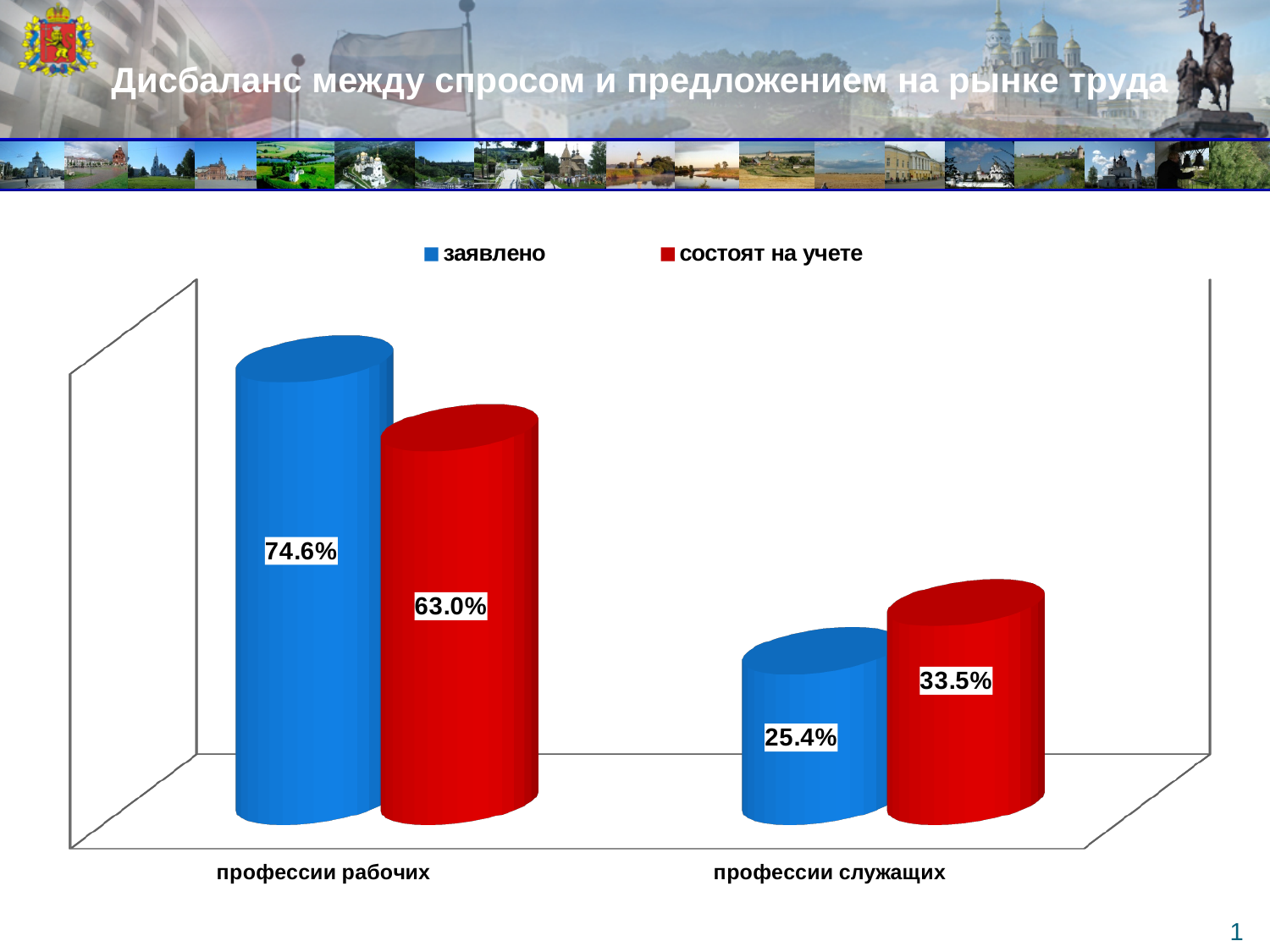
For "профессии служащих", which series has the larger value: "заявлено" or "состоят на учете"? состоят на учете What is the value for "состоят на учете" in the "профессии служащих" category? 33.5% Which category has the lowest value for "состоят на учете"? профессии служащих What is the difference between "заявлено" and "состоят на учете" for "профессии рабочих"? 11.6% What is the value for "заявлено" in the "профессии служащих" category? 25.4% What is the value for "заявлено" in the "профессии рабочих" category? 74.6% How many categories are shown on the x axis? 2 Which category has the highest value for "заявлено"? профессии рабочих What kind of chart is shown on the slide? bar chart What is the value for "состоят на учете" in the "профессии рабочих" category? 63.0% What is the difference between "состоят на учете" and "заявлено" for "профессии служащих"? 8.1% How many series does the legend list? 2